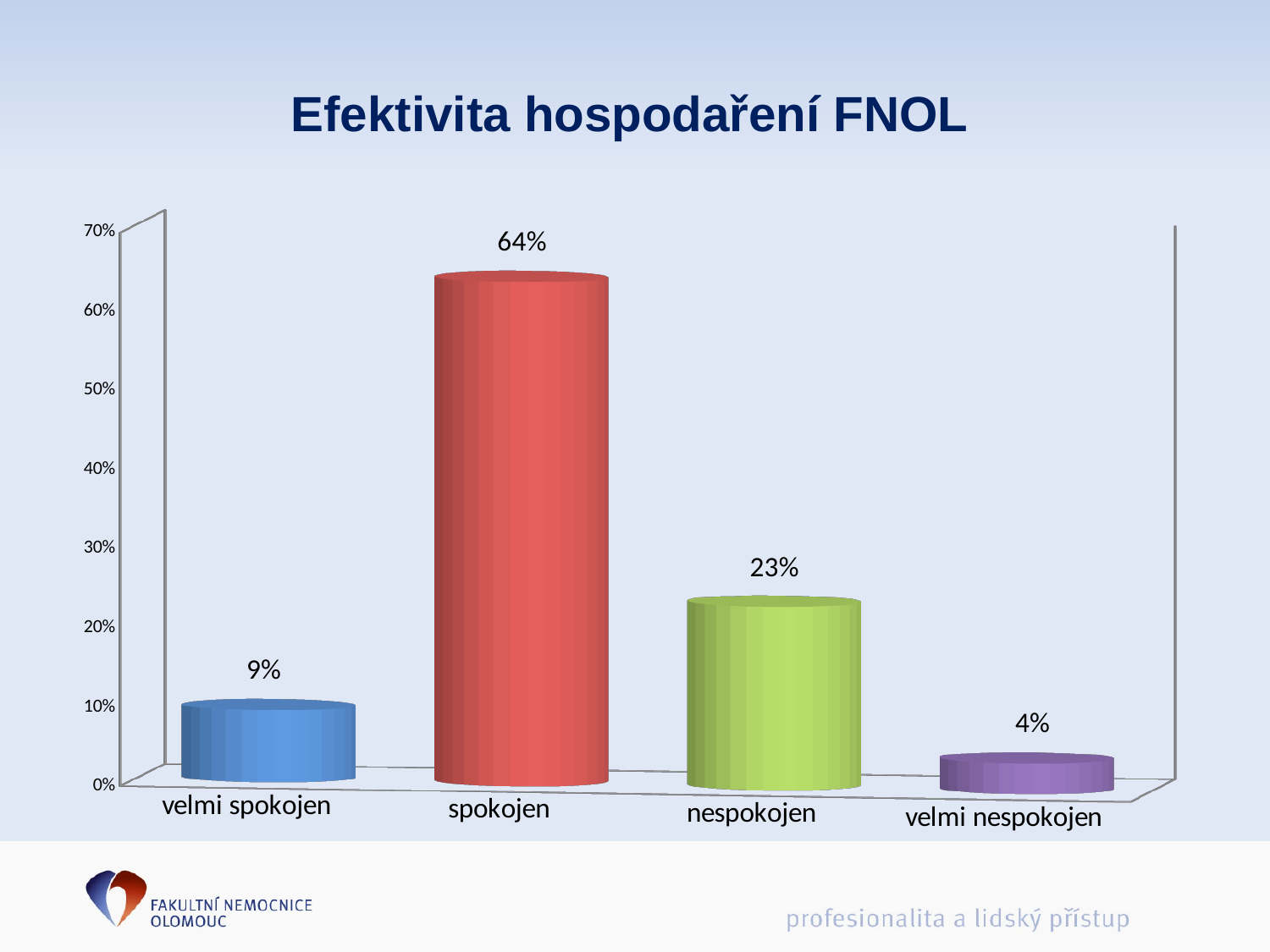
What is the value for "spokojen"? 64% What is the value for "nespokojen"? 23% What is the title of the slide? Efektivita hospodaření FNOL Which is larger, the value for "velmi spokojen" or the value for "velmi nespokojen"? velmi spokojen What is the value for "velmi spokojen"? 9% Is the value for "nespokojen" greater or less than 20%? greater What is the difference between the values for "spokojen" and "nespokojen"? 41% How many categories are shown on the x axis? 4 Which category has the highest value? spokojen What kind of chart is shown on the slide? bar chart Which category has the lowest value? velmi nespokojen What is the value for "velmi nespokojen"? 4%